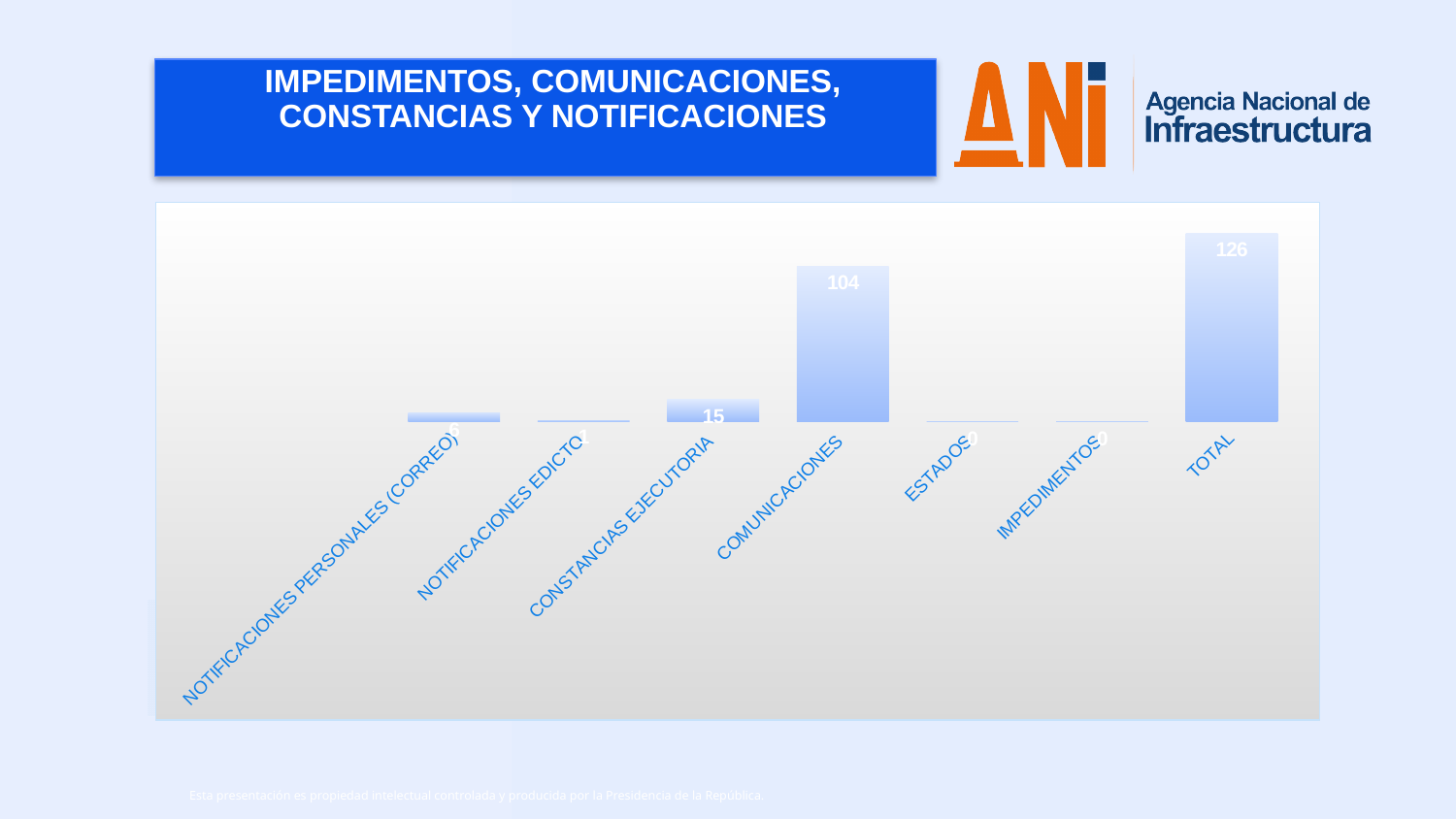
What is the value for NOTIFICACIONES EDICTO? 1 Which is larger, CONSTANCIAS EJECUTORIA or NOTIFICACIONES EDICTO? CONSTANCIAS EJECUTORIA Which category has the highest value? TOTAL Excluding TOTAL, which category has the highest value? COMUNICACIONES What is the value for TOTAL? 126 What is the difference between TOTAL and COMUNICACIONES? 22 How many categories are shown on the x axis? 7 What is the title shown in the blue box above the chart? IMPEDIMENTOS, COMUNICACIONES, CONSTANCIAS Y NOTIFICACIONES What is the value for ESTADOS? 0 What is the value for CONSTANCIAS EJECUTORIA? 15 What is the value for COMUNICACIONES? 104 What type of chart is shown on the slide? bar chart